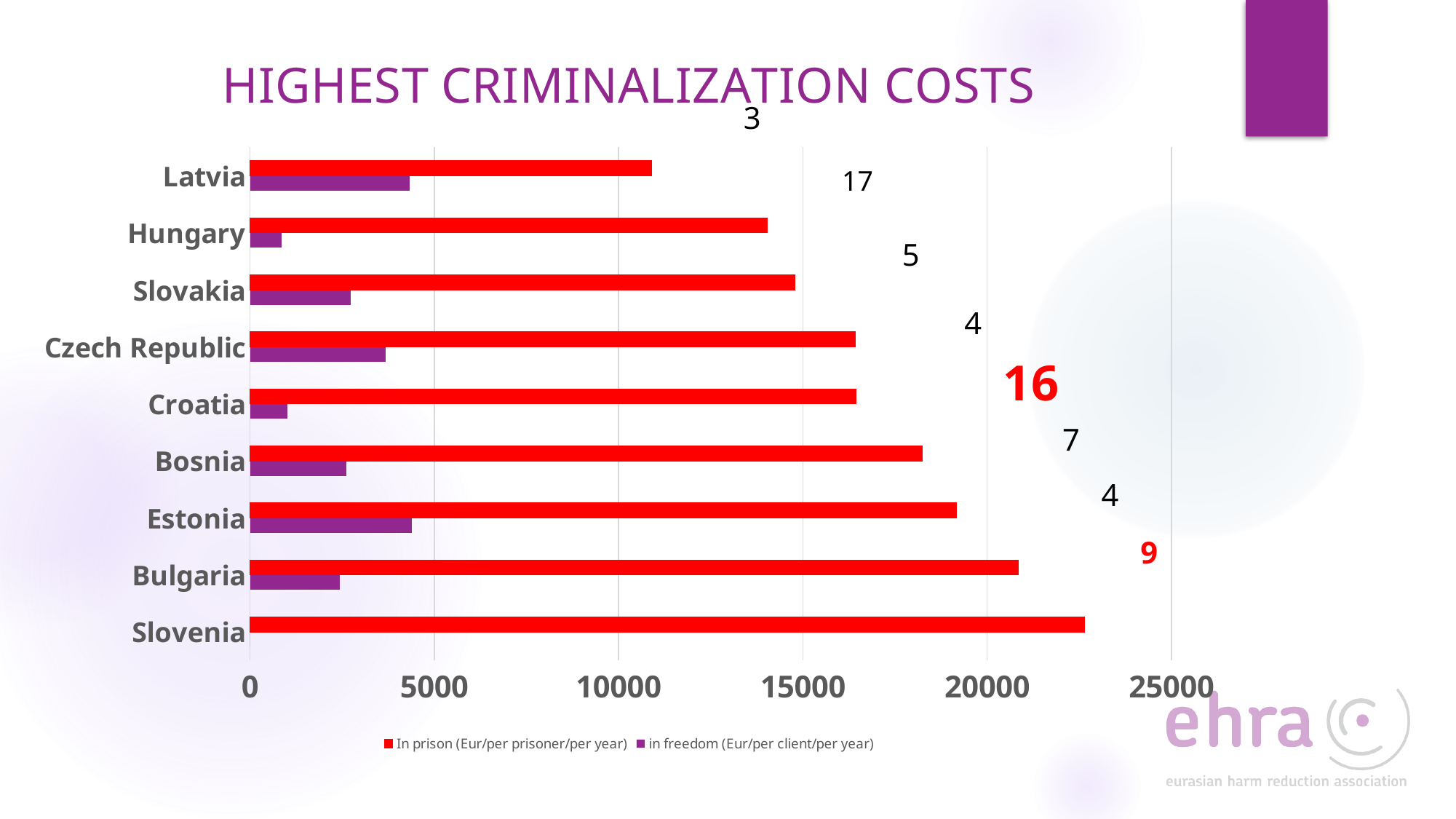
Which is larger, the 'In prison' value for Bulgaria or for Estonia? Bulgaria Is the 'In prison' value for Slovenia greater or less than 20000? greater Is the 'In prison' value for Latvia greater or less than 15000? less How many series does the legend list? 2 Which is larger, the 'in freedom' value for Czech Republic or for Croatia? Czech Republic What is the title of the chart? HIGHEST CRIMINALIZATION COSTS What kind of chart is shown on the slide? bar chart Is the 'In prison' value for Estonia greater or less than 20000? less Which country has the highest 'In prison (Eur/per prisoner/per year)' value? Slovenia Which country has the lowest 'In prison (Eur/per prisoner/per year)' value? Latvia How many countries are listed on the chart? 9